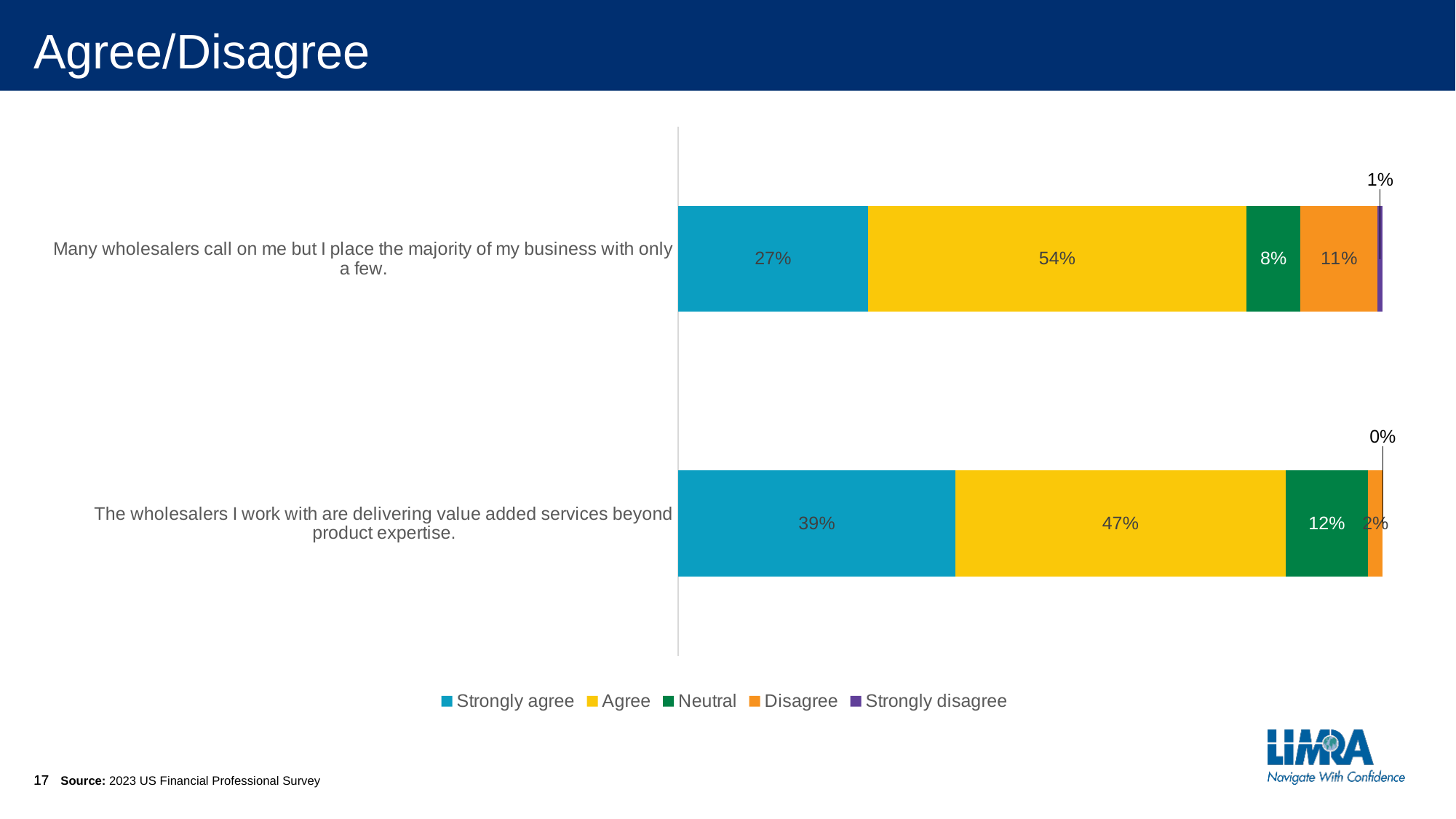
What is the Strongly disagree share for the statement about wholesalers delivering value added services beyond product expertise? 0% Which response category has the smallest share for the statement 'Many wholesalers call on me but I place the majority of my business with only a few'? Strongly disagree Which response category has the largest share for the statement 'Many wholesalers call on me but I place the majority of my business with only a few'? Agree How many response categories does the legend list? 5 What percentage of respondents agree that the wholesalers they work with are delivering value added services beyond product expertise? 47% What type of chart is shown on the slide? Stacked bar chart What is the Disagree share for the statement 'Many wholesalers call on me but I place the majority of my business with only a few'? 11% What percentage of respondents strongly agree that many wholesalers call on them but they place the majority of their business with only a few? 27% What is the difference between the Agree shares of the two statements (54% vs 47%)? 7% What is the Neutral share for the statement 'The wholesalers I work with are delivering value added services beyond product expertise'? 12% Which statement has the higher Strongly agree share? The wholesalers I work with are delivering value added services beyond product expertise. How many statements are plotted in the chart? 2